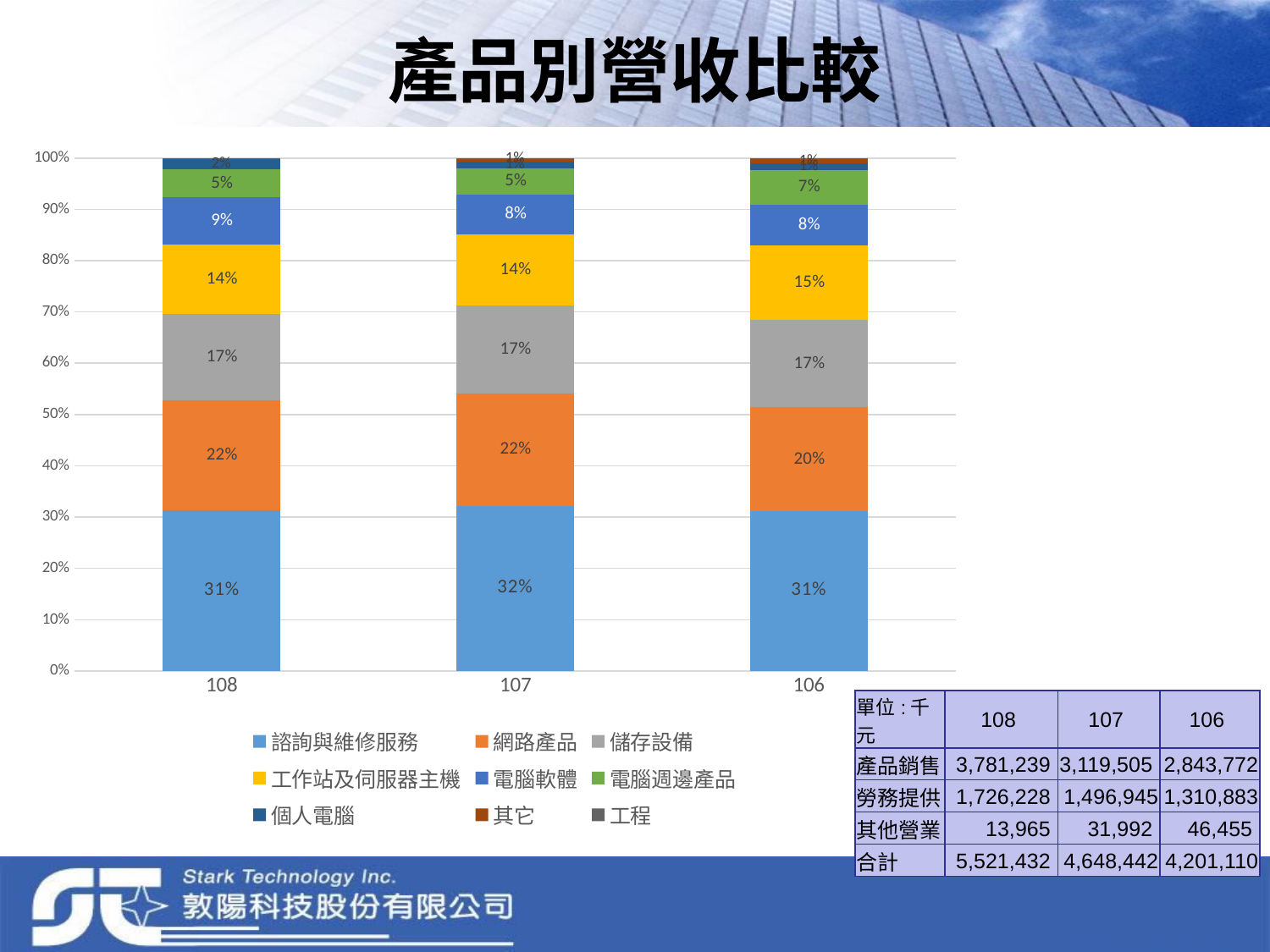
What kind of chart is shown on the slide? Stacked bar chart What is the value for 儲存設備 in 107? 17% What is the value for 工作站及伺服器主機 in 106? 15% What is the difference between the 電腦週邊產品 share in 106 and in 108? 2% What is the value for 諮詢與維修服務 in 108? 31% Which is larger, the 網路產品 share in 108 or in 106? 108 What is the value for 電腦週邊產品 in 106? 7% What is the value for 諮詢與維修服務 in 107? 32% How many series does the legend list? 9 What is the value for 網路產品 in 106? 20% What is the value for 電腦軟體 in 108? 9% How many categories (years) are shown on the x axis? 3